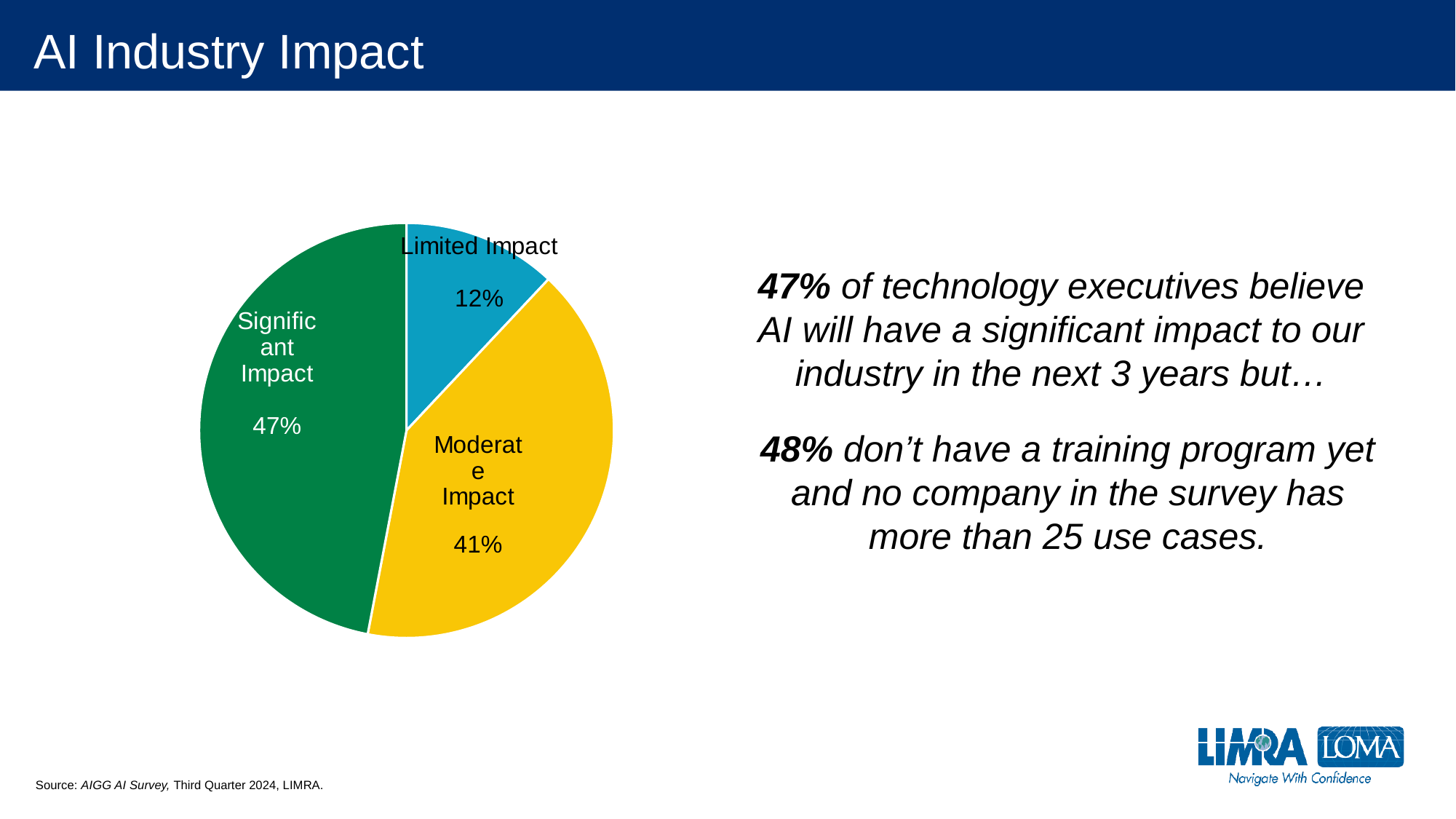
What is the difference in percentage points between Significant Impact and Moderate Impact? 6 How many slices does the pie chart have? 3 What percentage of the pie is Limited Impact? 12% What colour is the Limited Impact slice? Blue What kind of chart is shown on the slide? Pie chart Which slice of the pie is the largest? Significant Impact What colour is the Significant Impact slice? Green What percentage of the pie is Significant Impact? 47% Which slice of the pie is the smallest? Limited Impact What is the difference in percentage points between Moderate Impact and Limited Impact? 29 What percentage of the pie is Moderate Impact? 41% Which is larger, the Moderate Impact slice or the Limited Impact slice? Moderate Impact